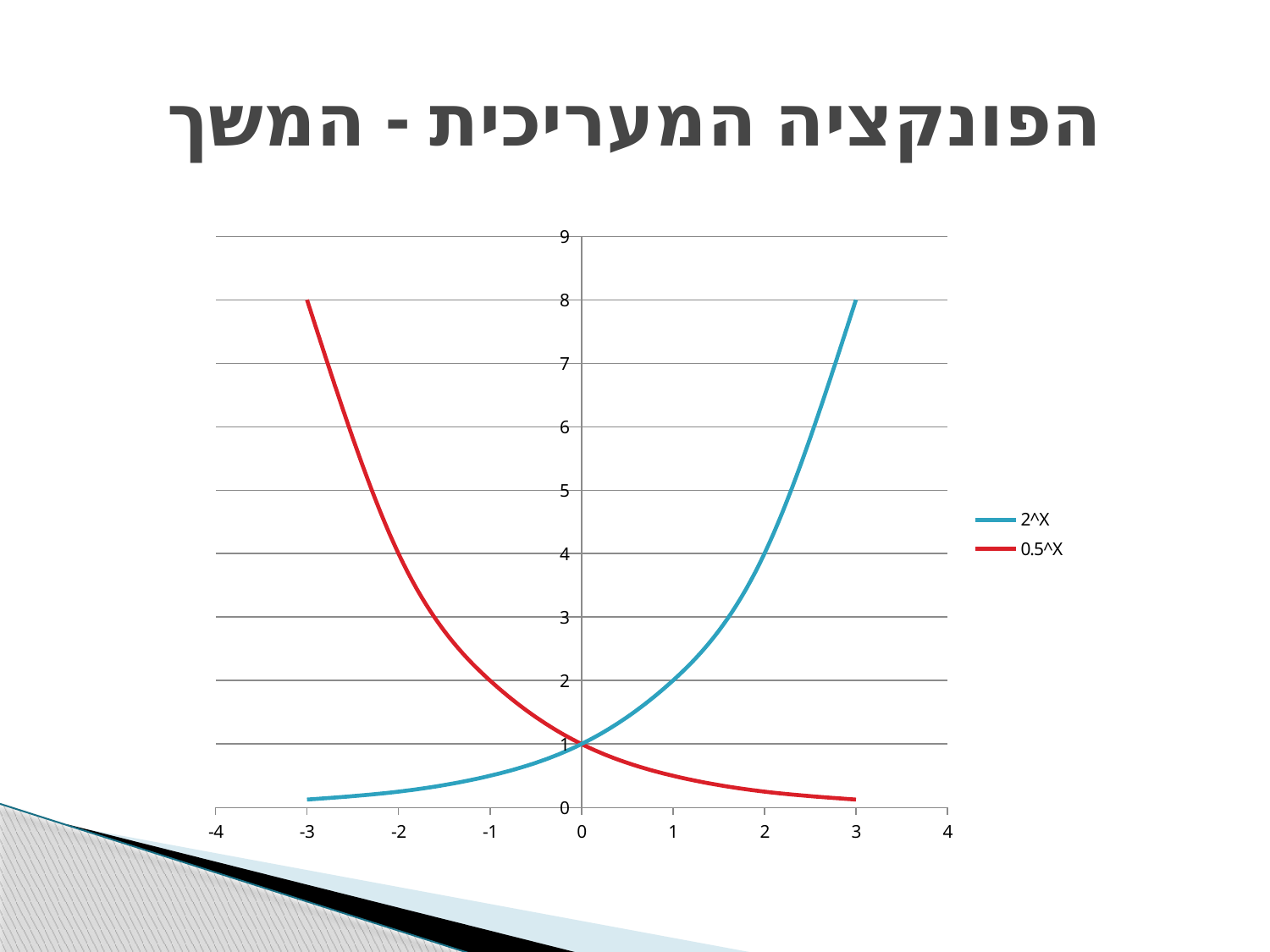
Does the 2^X series rise or fall as x increases? rises Is the value of 0.5^X at x = 2 greater or less than 1? less What is the value of 0.5^X at x = -3? 8 What is the value of 2^X at x = 0? 1 Does the 0.5^X series rise or fall as x increases? falls Which colour is used for the 0.5^X series? red Is the value of 2^X at x = -2 greater or less than 1? less How many series does the legend list? 2 At x = 2, which series has the larger value, 2^X or 0.5^X? 2^X What is the value of 2^X at x = 3? 8 What kind of chart is shown on the slide? line chart What are the two series named in the legend? 2^X and 0.5^X